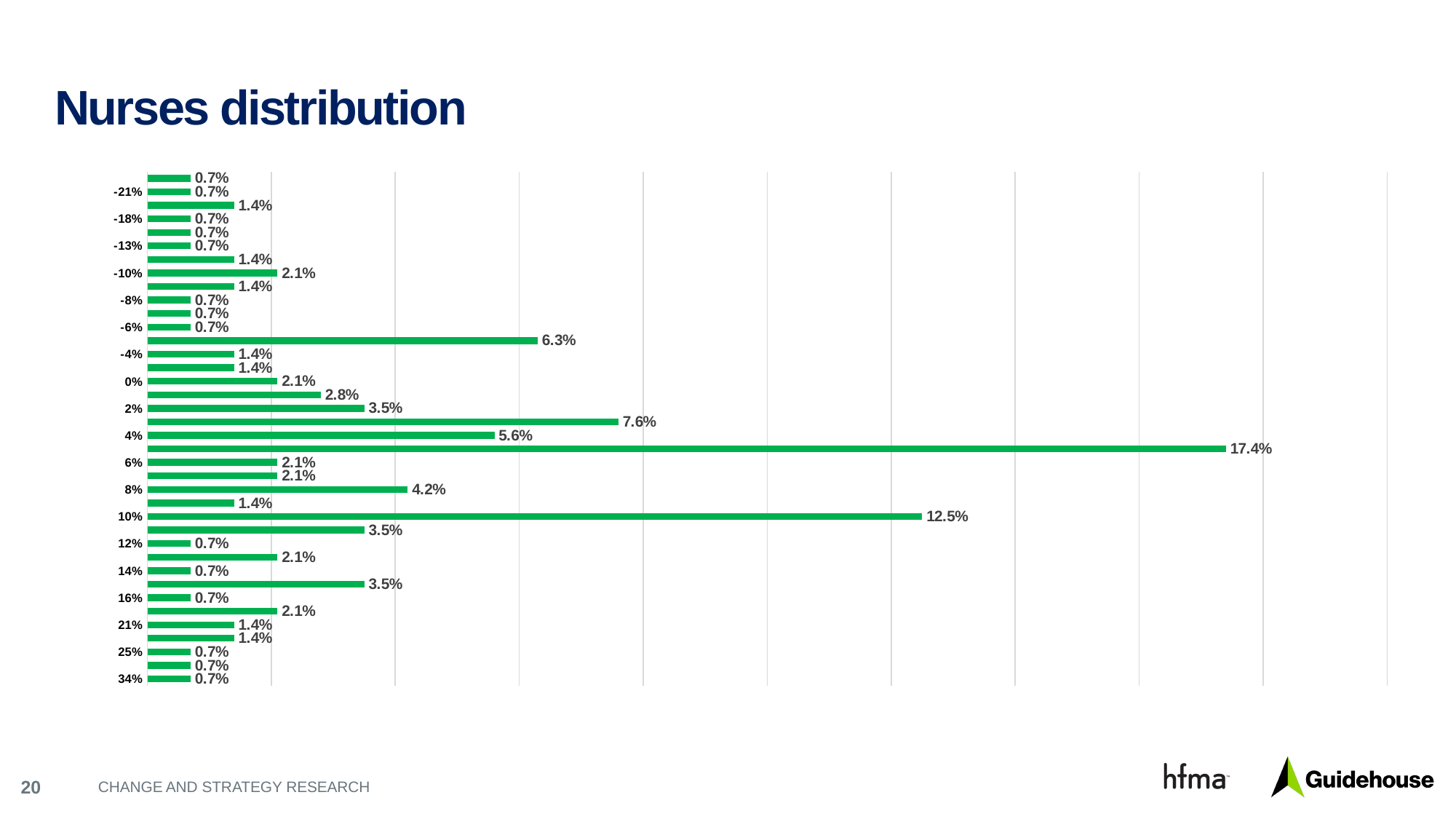
What kind of chart is shown on the slide? Bar chart What is the difference between the values for the 4% category and the 8% category? 1.4% What is the value of the bar for the 4% category? 5.6% What is the value of the bar for the 8% category? 4.2% What is the value of the bar for the 10% category? 12.5% How many bars are plotted in the chart? 38 Which has the larger value, the 8% category or the 2% category? 8% What is the value of the bar for the -10% category? 2.1% What is the title of the slide? Nurses distribution What is the value of the bar for the 2% category? 3.5% What is the largest value shown by any bar in the chart? 17.4% What is the difference between the values for the 10% category and the 4% category? 6.9%